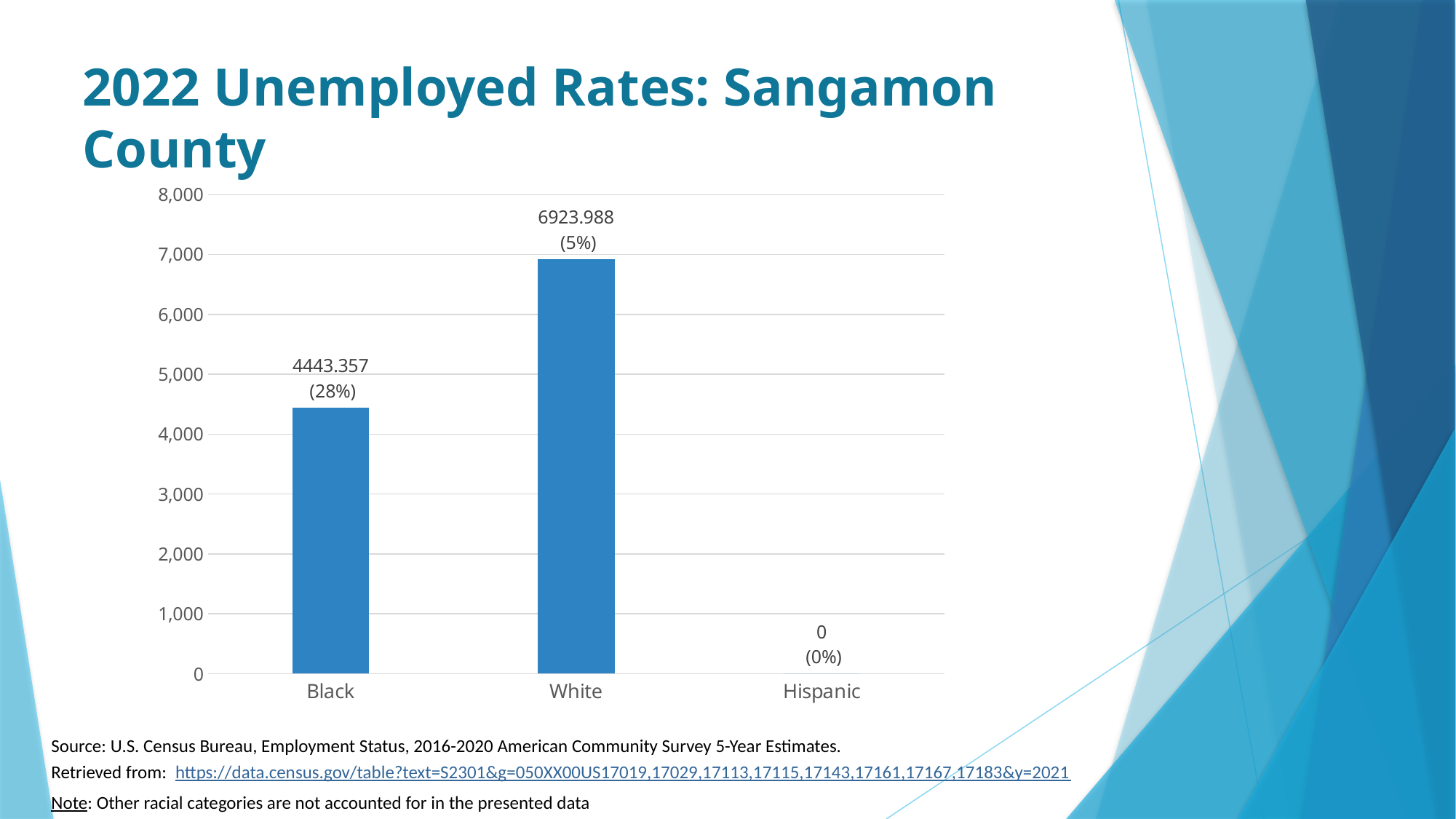
Is the value for Black greater or less than 4,000? greater What percentage is shown in parentheses for the Black category? 28% What is the difference between the values for White and Black? 2480.631 What value is shown for the White category? 6923.988 What value is shown for the Hispanic category? 0 Which is larger, the value for Black or the value for White? White What kind of chart is shown on the slide? bar chart Which category has the lowest value? Hispanic How many categories are shown on the x axis? 3 What percentage is shown in parentheses for the White category? 5% Which category has the highest value? White What value is shown for the Black category? 4443.357